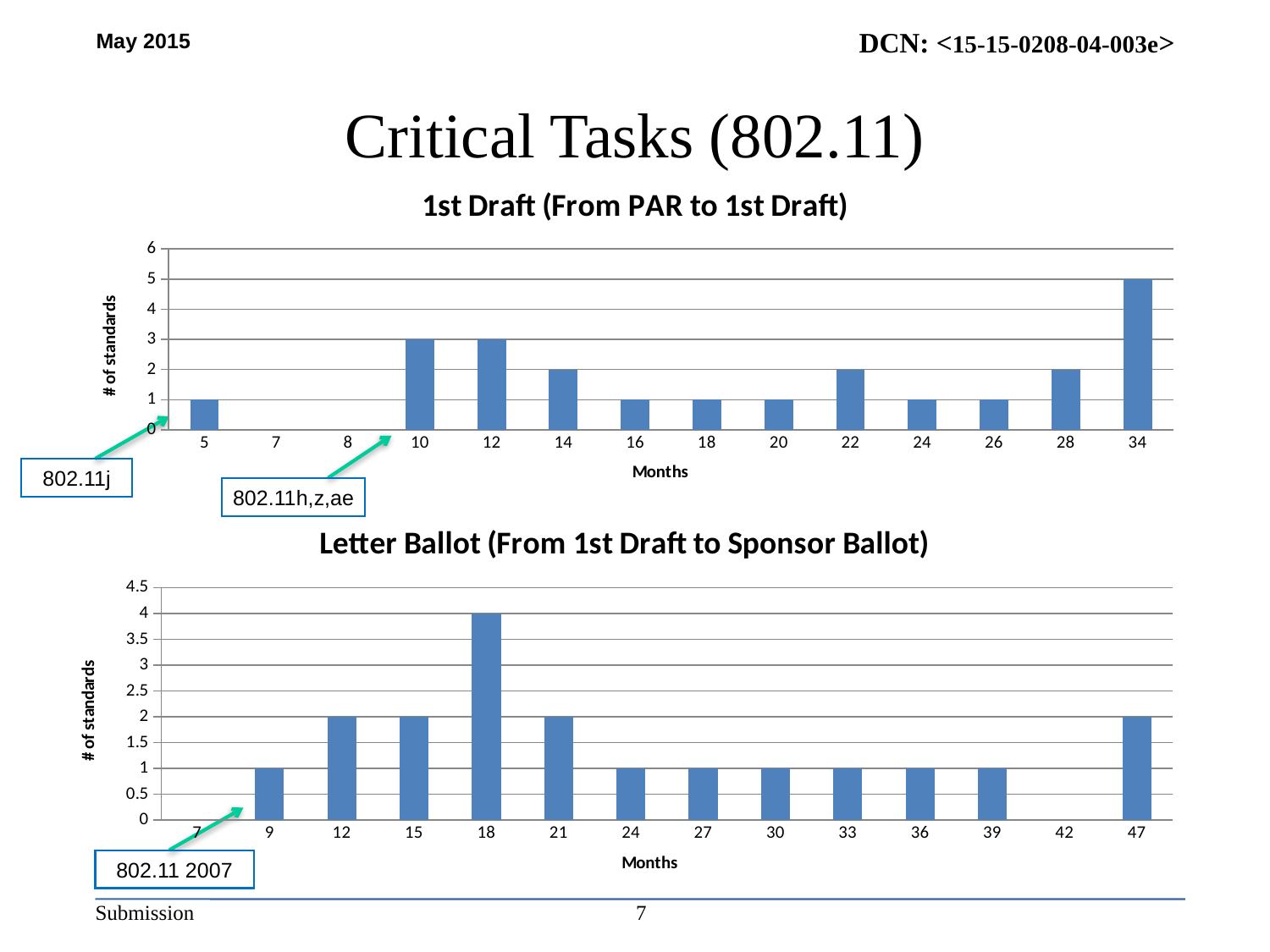
What is the y-axis label of the '1st Draft (From PAR to 1st Draft)' chart? # of standards In the '1st Draft (From PAR to 1st Draft)' chart, what is the difference between the number of standards at 34 months and at 14 months? 3 In the 'Letter Ballot (From 1st Draft to Sponsor Ballot)' chart, how many standards are shown for 18 months? 4 In the 'Letter Ballot (From 1st Draft to Sponsor Ballot)' chart, how many standards are shown for 47 months? 2 In the 'Letter Ballot (From 1st Draft to Sponsor Ballot)' chart, what is the difference between the number of standards at 18 months and at 12 months? 2 In the '1st Draft (From PAR to 1st Draft)' chart, which month has the highest number of standards? 34 In the 'Letter Ballot (From 1st Draft to Sponsor Ballot)' chart, which month has the highest number of standards? 18 In the '1st Draft (From PAR to 1st Draft)' chart, how many standards are shown for 34 months? 5 In the '1st Draft (From PAR to 1st Draft)' chart, which is larger: the value at 22 months or the value at 24 months? 22 months In the '1st Draft (From PAR to 1st Draft)' chart, how many standards are shown for 10 months? 3 What type of chart is the 'Letter Ballot (From 1st Draft to Sponsor Ballot)' chart? Bar chart In the '1st Draft (From PAR to 1st Draft)' chart, how many month categories are shown on the x axis? 14